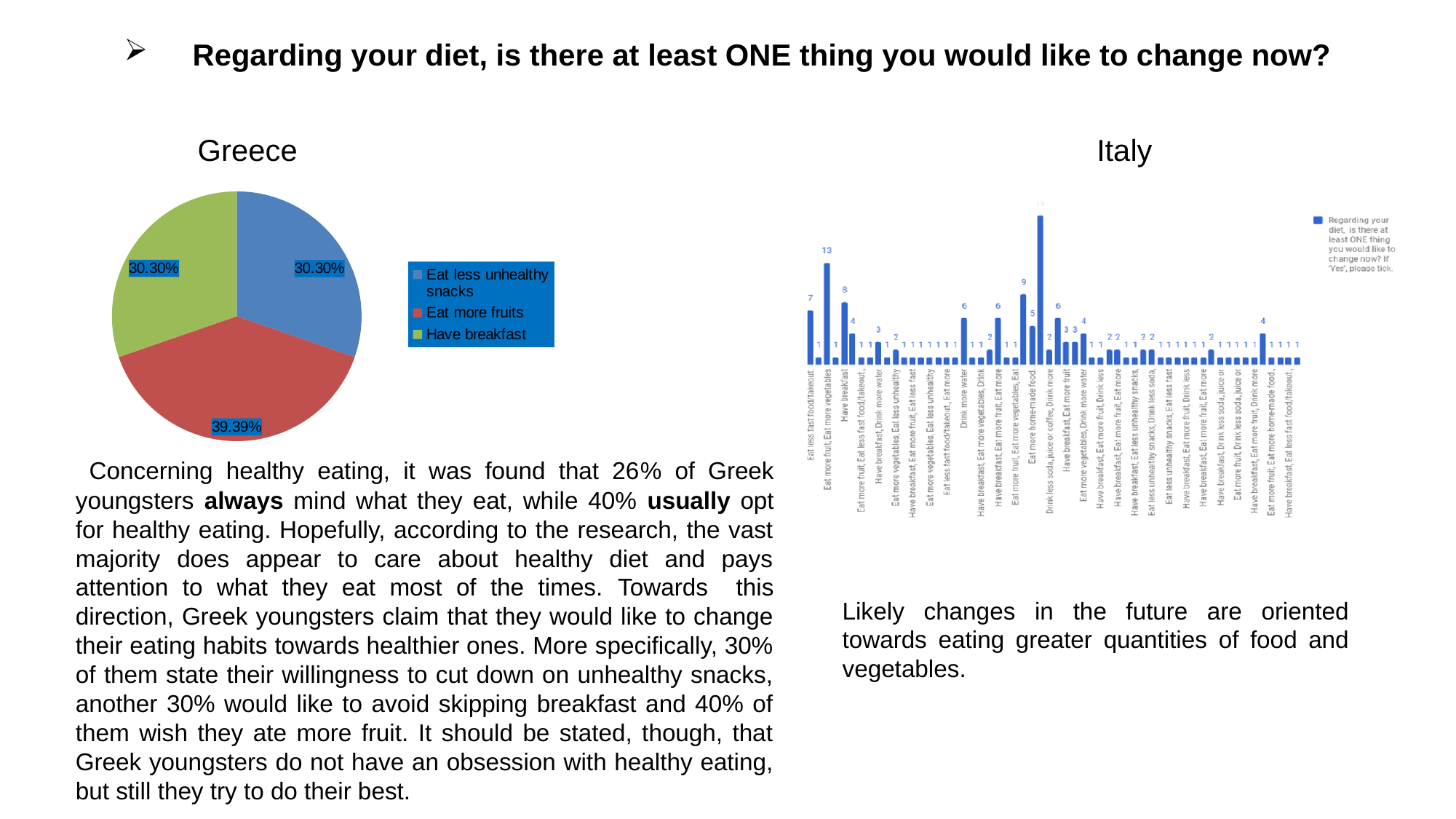
In the Italy bar chart, what is the value for 'Have breakfast'? 8 In the Greece pie chart, what is the difference between the 'Eat more fruits' share and the 'Have breakfast' share? 9.09% In the Italy bar chart, what is the value for 'Eat more fruit, Eat more vegetables'? 13 In the Greece pie chart, what share of respondents chose 'Eat less unhealthy snacks'? 30.30% In the Italy bar chart, which is larger: the value for 'Eat less fast food/takeout' or the value for 'Have breakfast'? Have breakfast How many slices does the Greece pie chart have? 3 In the Greece pie chart, what share of respondents chose 'Eat more fruits'? 39.39% What kind of chart is the Italy chart? Bar chart In the Greece pie chart, which category has the largest slice? Eat more fruits In the Greece pie chart, what colour is the 'Eat more fruits' slice? Red What kind of chart is the Greece chart? Pie chart In the Greece pie chart, what share of respondents chose 'Have breakfast'? 30.30%